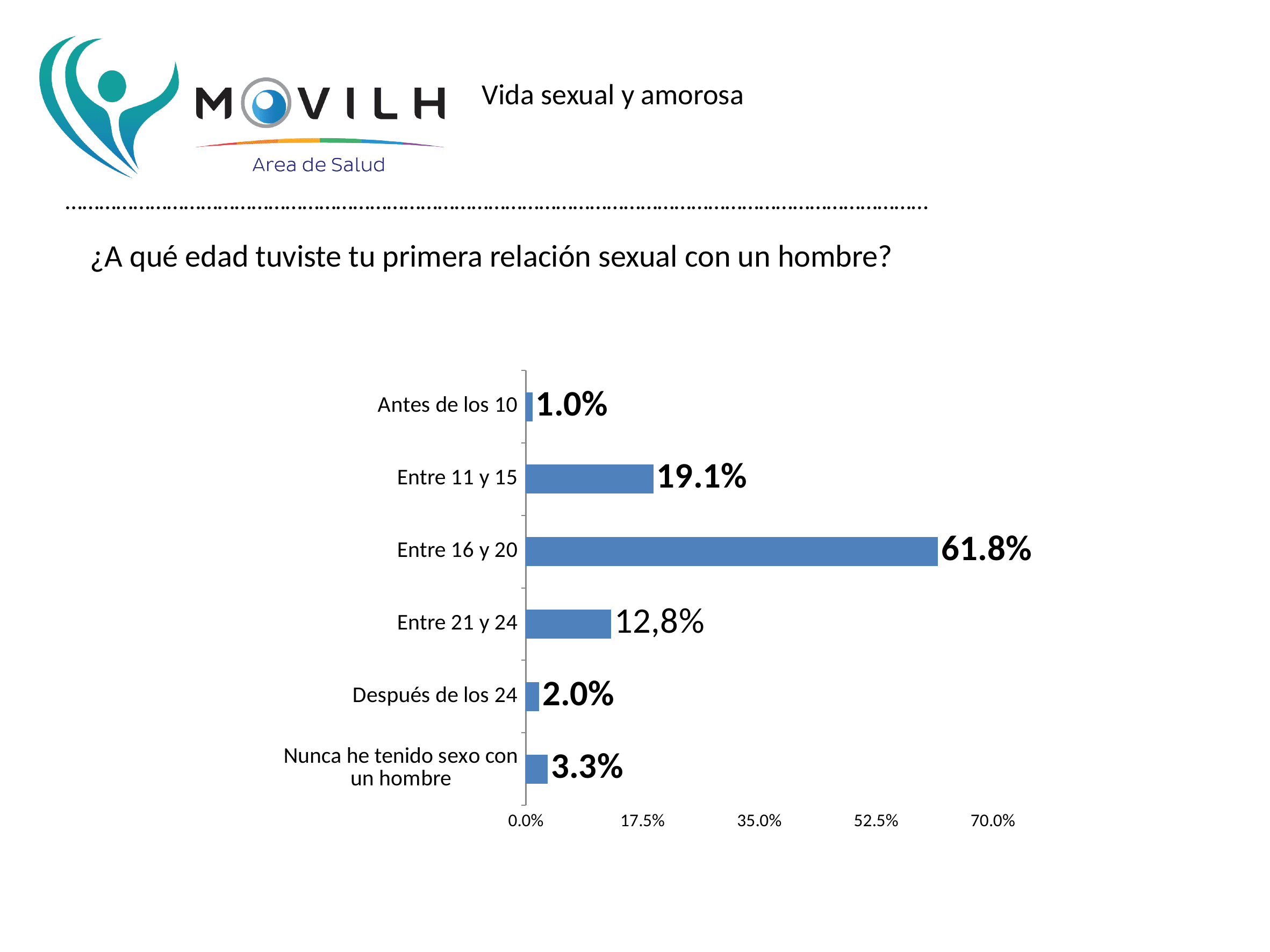
Which category has the highest value? Entre 16 y 20 What is the highest value shown on the x axis? 70.0% What is the value for "Entre 16 y 20"? 61.8% How many categories are shown in the chart? 6 What is the value for "Nunca he tenido sexo con un hombre"? 3.3% What is the difference between the values for "Entre 16 y 20" and "Entre 11 y 15"? 42.7% Is the value for "Entre 16 y 20" greater or less than 52.5%? greater What is the value for "Después de los 24"? 2.0% Which category has the lowest value? Antes de los 10 What kind of chart is shown on the slide? Bar chart What is the value for "Entre 11 y 15"? 19.1% Which is larger, the value for "Entre 11 y 15" or the value for "Entre 21 y 24"? Entre 11 y 15